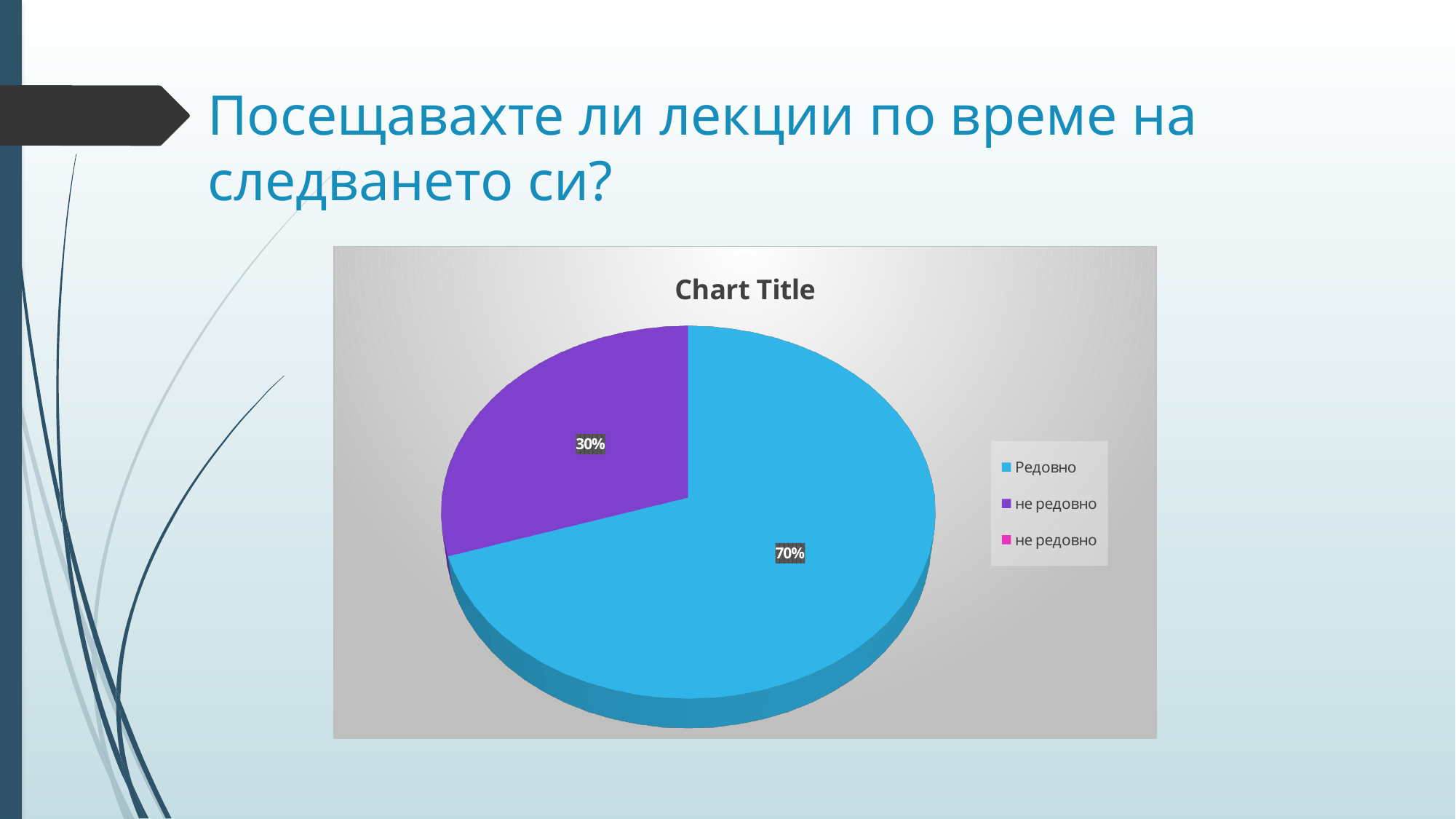
What share of the pie does the "Редовно" slice represent? 70% How many slices are visible in the pie chart? 2 What kind of chart is shown on the slide? pie chart How many entries does the legend list? 3 Which visible slice of the pie is the smallest? не редовно Which slice of the pie is the largest? Редовно What colour is the "Редовно" slice of the pie? blue Which is larger, the "Редовно" slice or the purple "не редовно" slice? Редовно What is the title printed above the pie chart? Chart Title Is the share of the "Редовно" slice greater or less than 50%? greater What is the difference in percentage points between the "Редовно" slice and the purple "не редовно" slice? 40 What share of the pie does the purple "не редовно" slice represent? 30%